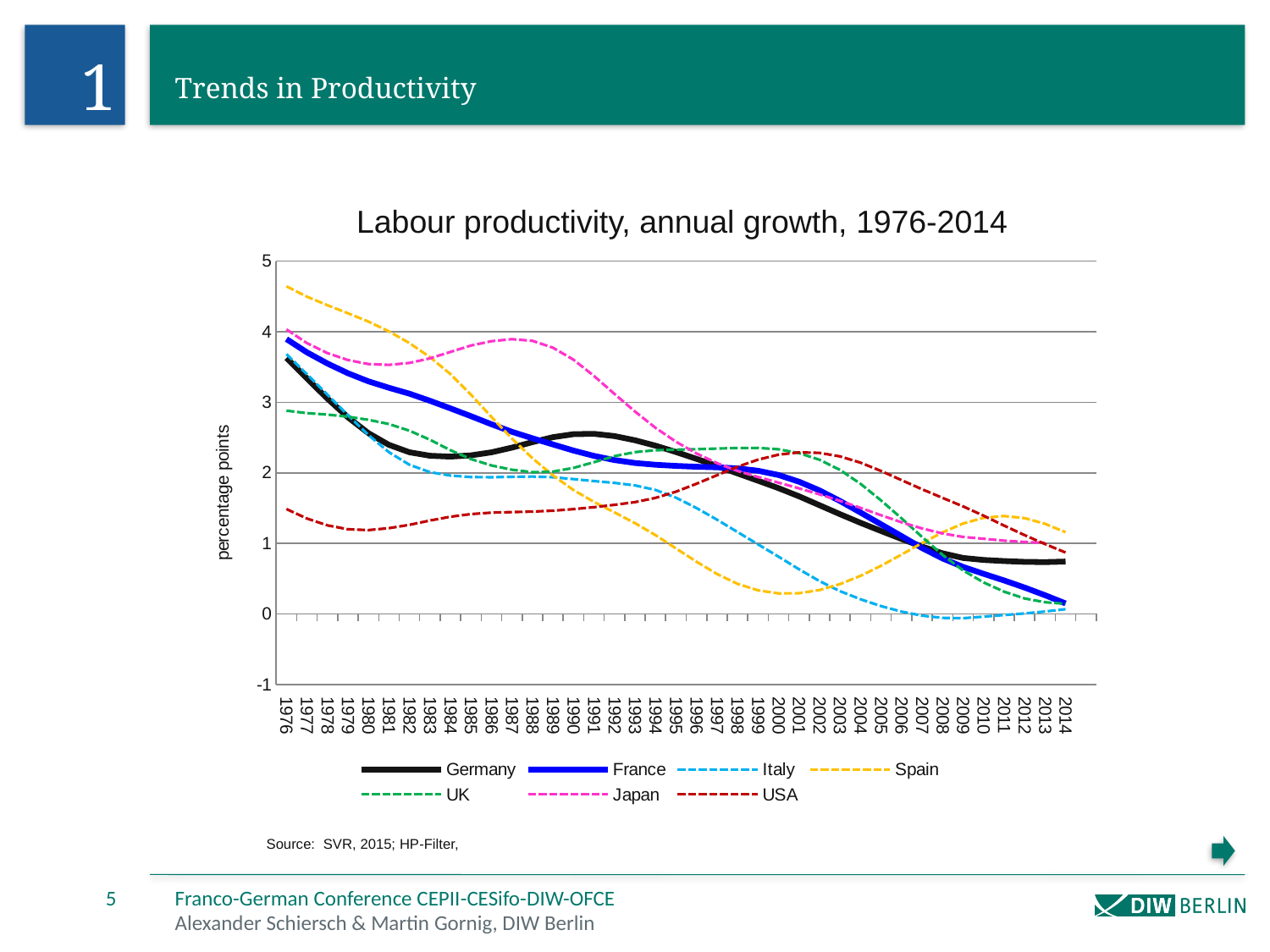
How many series does the legend list? 7 Which country has the highest value in 1976? Spain What kind of chart is shown on the slide? line chart How many years are plotted along the x axis? 39 Which country has the highest value in 1987? Japan Is the value for Germany in 2014 greater or less than 1? less What is the label on the y axis? percentage points Is the value for Spain in 1976 greater or less than 4? greater Does the Germany line rise or fall overall from 1976 to 2014? fall Which country has the lowest value in 1976? USA In 2014, which is larger, the value for USA or the value for Italy? USA What is the title of the chart? Labour productivity, annual growth, 1976-2014